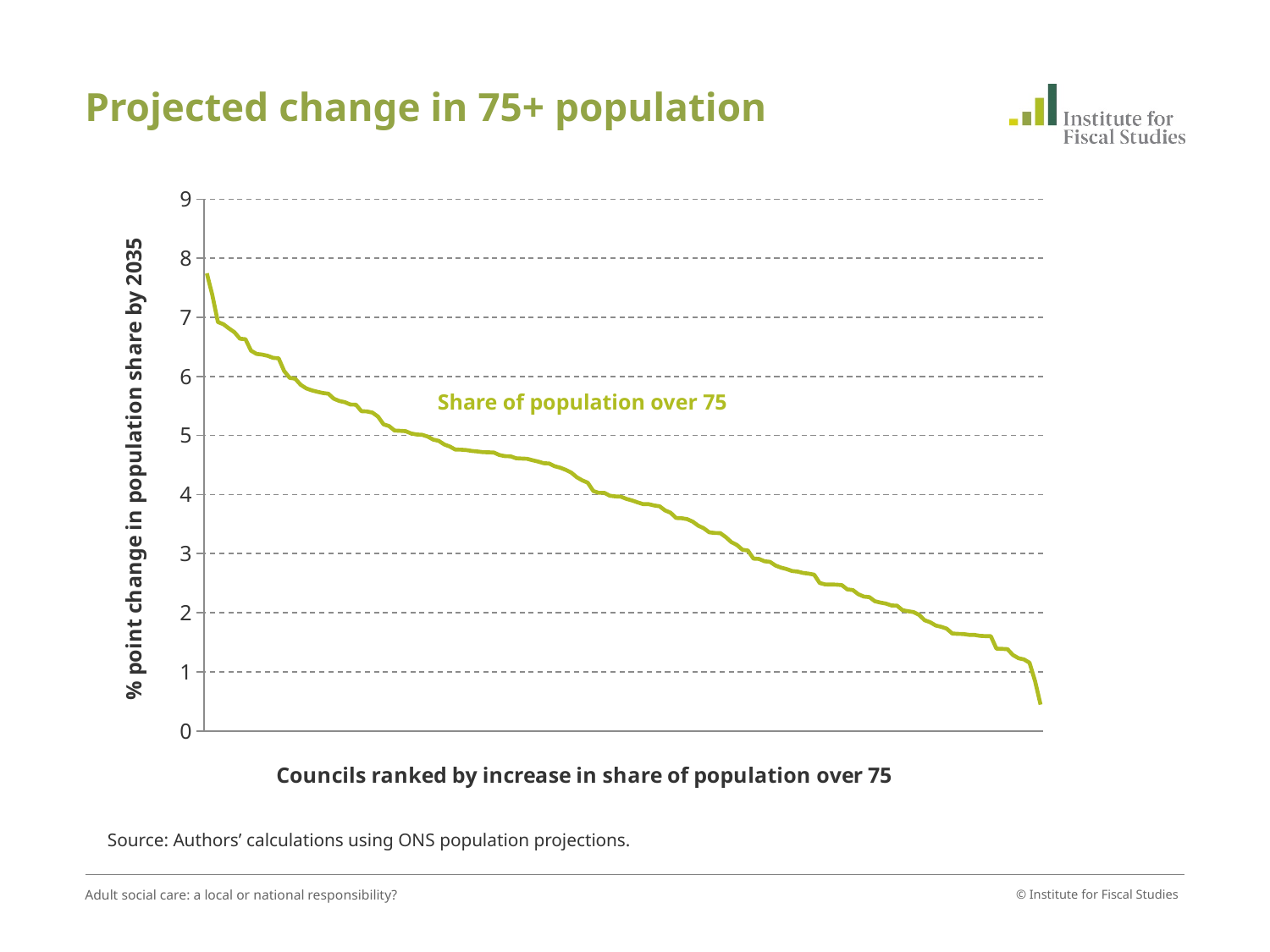
Is the value for the leftmost council greater or less than 8? less What is the name of the series plotted on the chart? Share of population over 75 What is the label of the x axis? Councils ranked by increase in share of population over 75 Which end of the line is higher, the left end or the right end? left end What kind of chart is shown on the slide? line chart How many series are plotted on the chart? 1 Do the values rise or fall moving from left to right along the x axis? fall What is the maximum value shown on the y axis? 9 Is the value for the rightmost (lowest-ranked) council greater or less than 1? less Is the value for the leftmost (highest-ranked) council greater or less than 7? greater